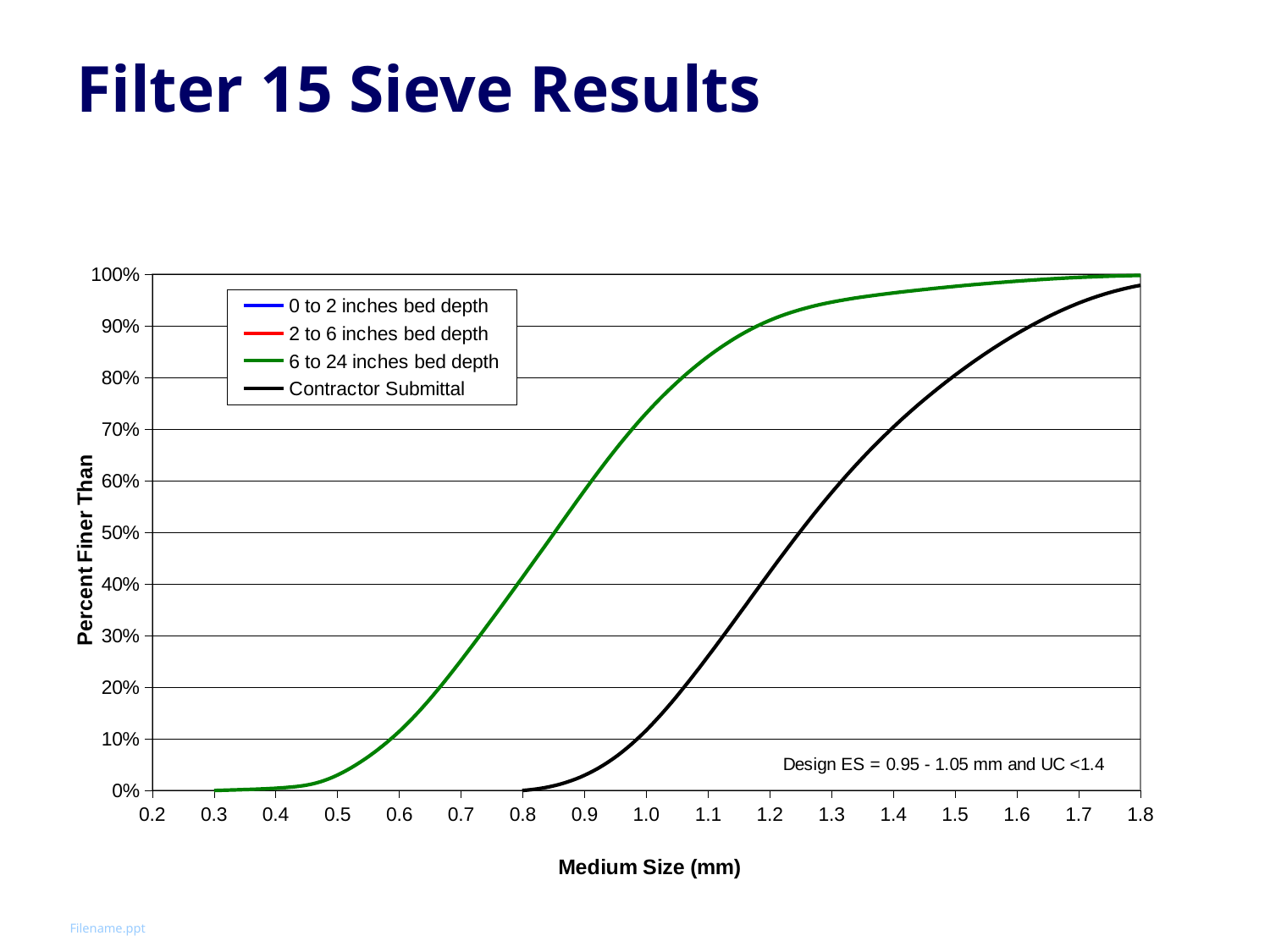
Is the value for the Contractor Submittal curve at 1.7 mm greater or less than 90%? greater At 1.0 mm, which curve has the higher percent finer than: 6 to 24 inches bed depth or Contractor Submittal? 6 to 24 inches bed depth Is the value for the 6 to 24 inches bed depth curve at 0.5 mm greater or less than 10%? less What is the title of the x axis? Medium Size (mm) Which series reaches 50% finer than at the largest medium size? Contractor Submittal How many series does the legend list? 4 Is the value for the Contractor Submittal curve at 0.9 mm greater or less than 10%? less What design criteria text is printed inside the chart area? Design ES = 0.95 - 1.05 mm and UC <1.4 Do the plotted curves rise or fall as medium size increases along the x axis? rise What kind of chart is shown on the slide? line chart